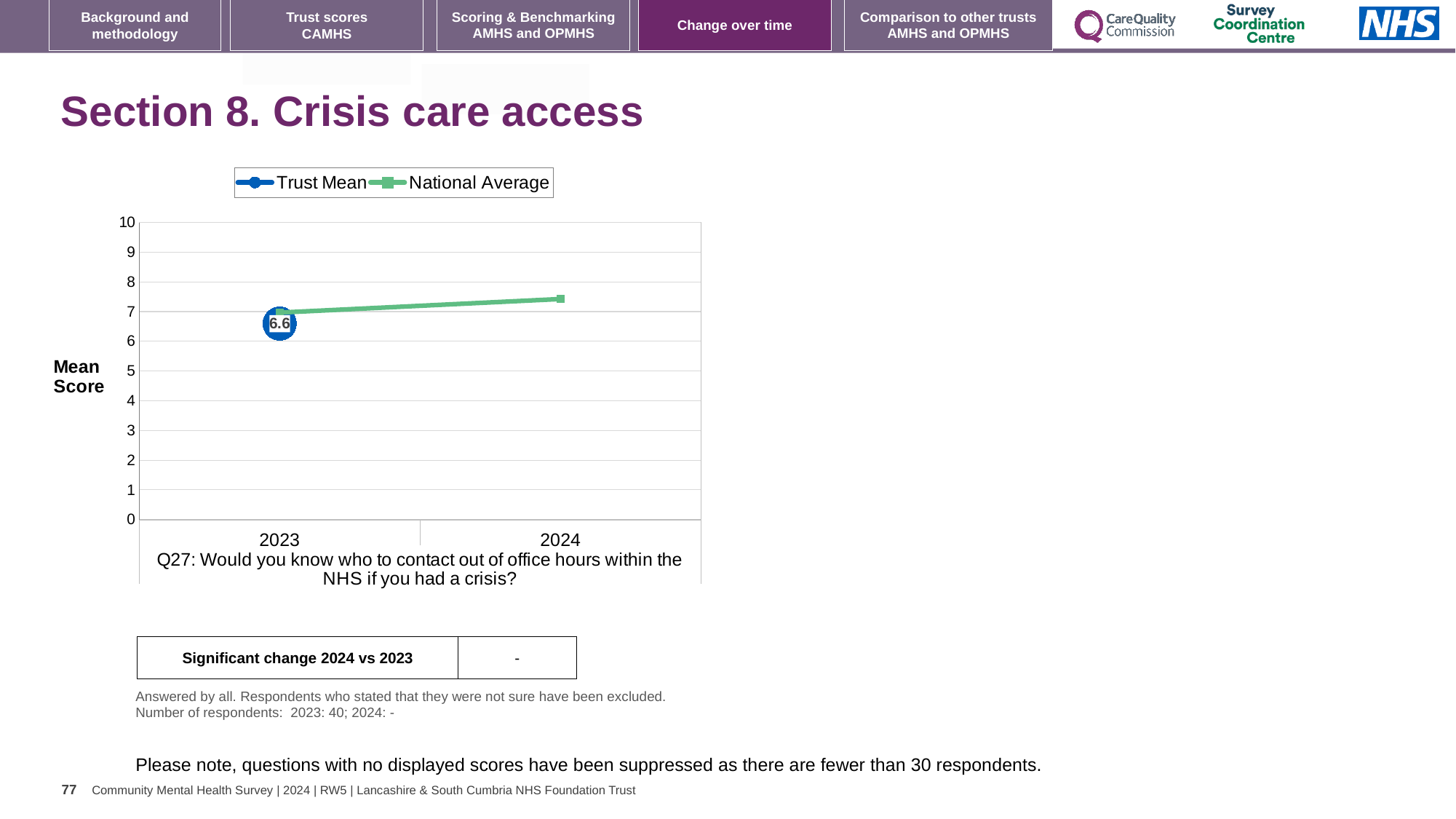
Which year has the higher National Average value? 2024 Which series is shown in green? National Average What is the label on the y axis of the chart? Mean Score Is the National Average value for 2024 greater or less than 7? greater Which is larger: the National Average for 2024 or the Trust Mean for 2023? National Average for 2024 What kind of chart is shown on the slide? line chart How many years are shown on the x axis? 2 Is the Trust Mean value for 2023 greater or less than 7? less How many series does the legend list? 2 Does the National Average rise or fall from 2023 to 2024? rise What is the Trust Mean score for 2023? 6.6